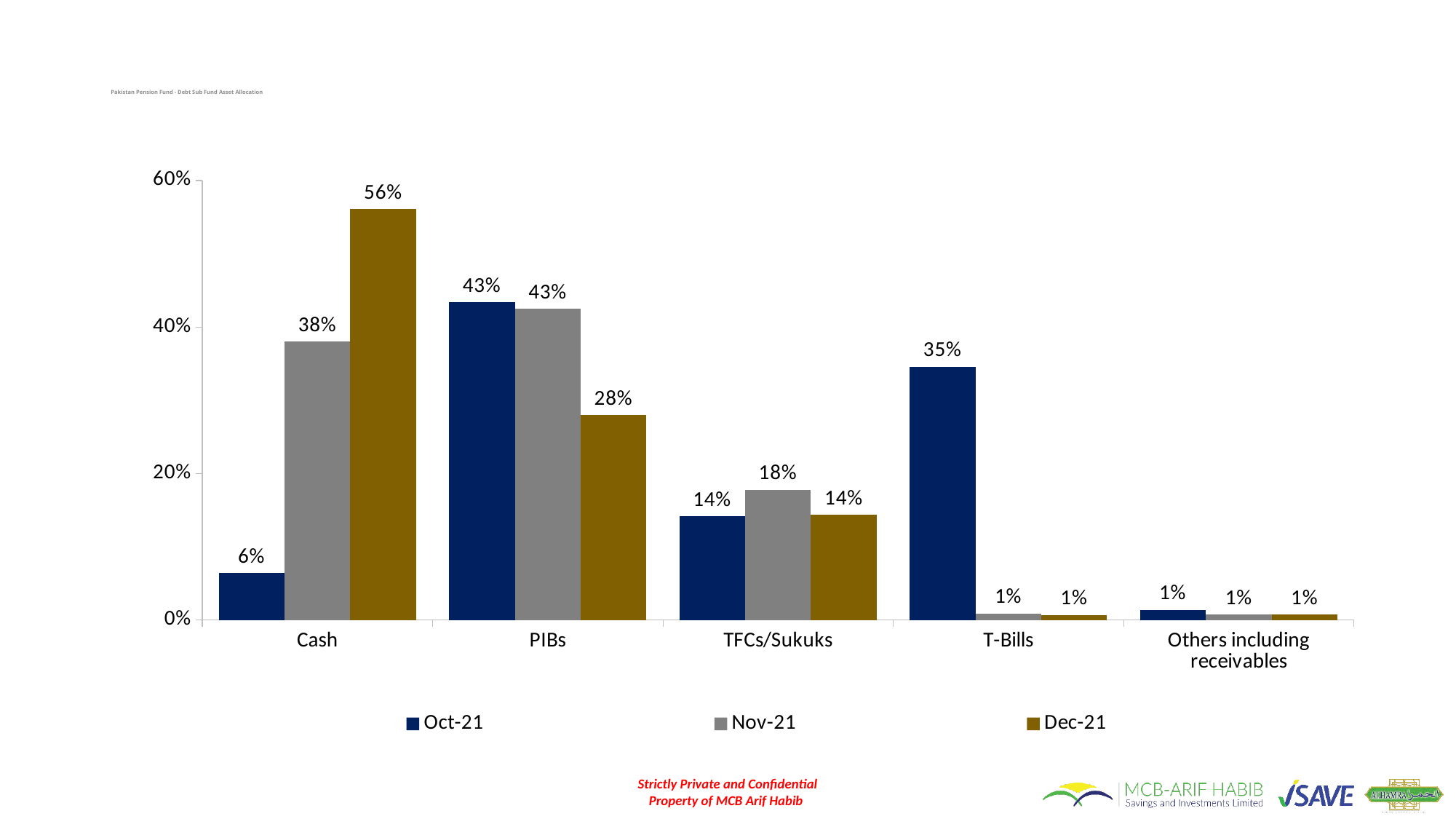
Which is larger for PIBs: the Nov-21 value or the Dec-21 value? Nov-21 What kind of chart is shown on the slide? Bar chart How many series does the legend list? 3 Which series is shown in gold/brown in the legend? Dec-21 What is the Nov-21 value for TFCs/Sukuks? 18% Which category has the highest Dec-21 value? Cash Which category has the lowest Oct-21 value? Others including receivables What is the Oct-21 value for T-Bills? 35% How many categories are shown on the x axis? 5 What is the Dec-21 value for PIBs? 28% What is the Dec-21 value for Cash? 56% What is the difference between the Dec-21 and Oct-21 values for Cash? 50%